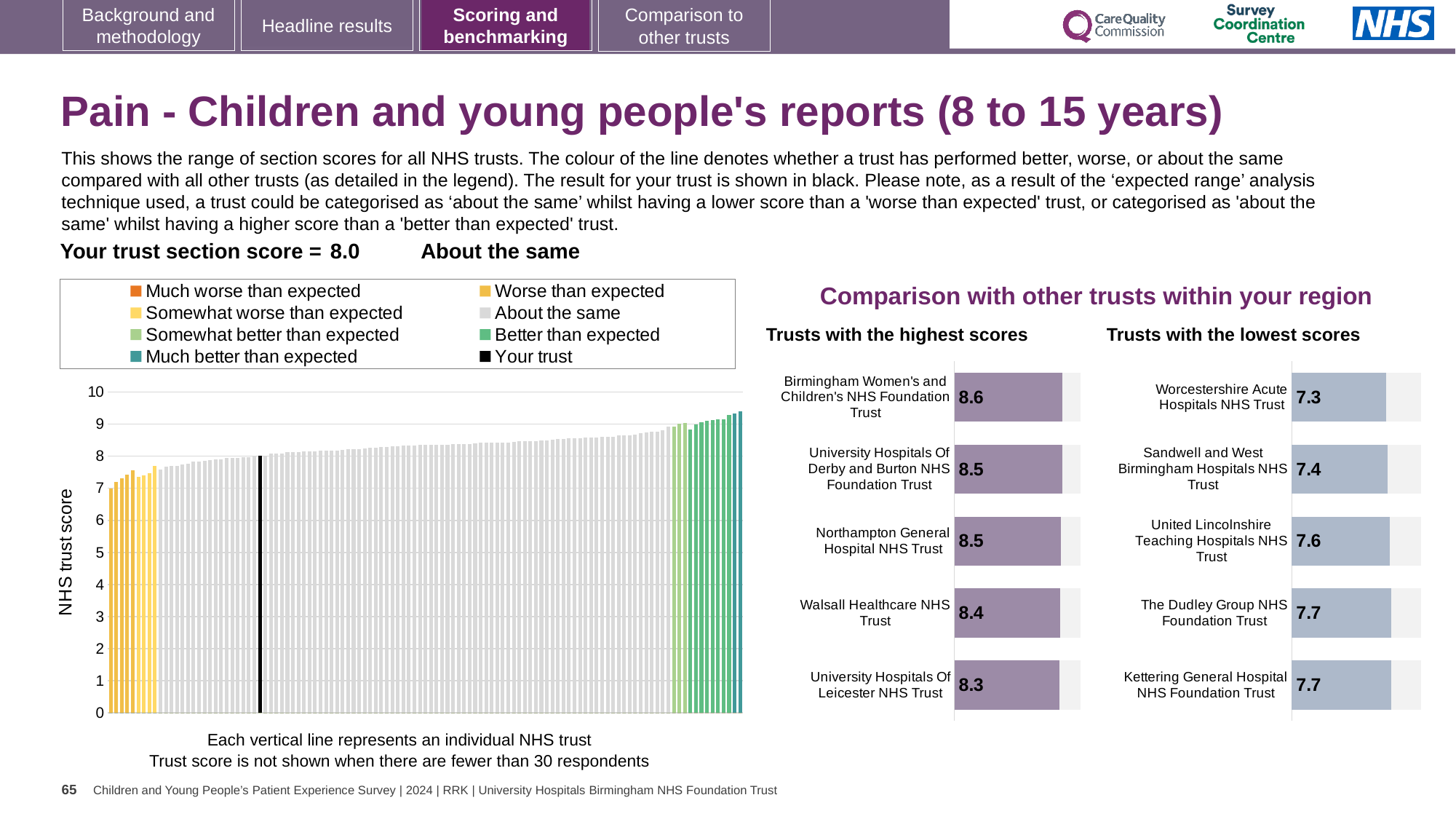
In the 'Trusts with the lowest scores' chart, what is the score for Worcestershire Acute Hospitals NHS Trust? 7.3 Comparing the right-hand charts, which has the higher score: Walsall Healthcare NHS Trust or The Dudley Group NHS Foundation Trust? Walsall Healthcare NHS Trust In the 'Trusts with the highest scores' chart, what is the difference between the scores of Birmingham Women's and Children's NHS Foundation Trust and University Hospitals Of Leicester NHS Trust? 0.3 In the 'Trusts with the lowest scores' chart, what is the difference between the scores of Kettering General Hospital NHS Foundation Trust and Worcestershire Acute Hospitals NHS Trust? 0.4 In the 'Trusts with the highest scores' chart, what is the score for Birmingham Women's and Children's NHS Foundation Trust? 8.6 What kind of chart is the main 'NHS trust score' chart on the left? bar chart In the 'Trusts with the lowest scores' chart, which trust has the lowest score? Worcestershire Acute Hospitals NHS Trust In the 'Trusts with the highest scores' chart, which trust has the highest score? Birmingham Women's and Children's NHS Foundation Trust What is the section score for your trust shown on the slide? 8.0 How many trusts are listed in the 'Trusts with the highest scores' chart? 5 How many entries does the legend of the main 'NHS trust score' chart list? 8 In the main 'NHS trust score' chart, do the bar values rise or fall from left to right? rise